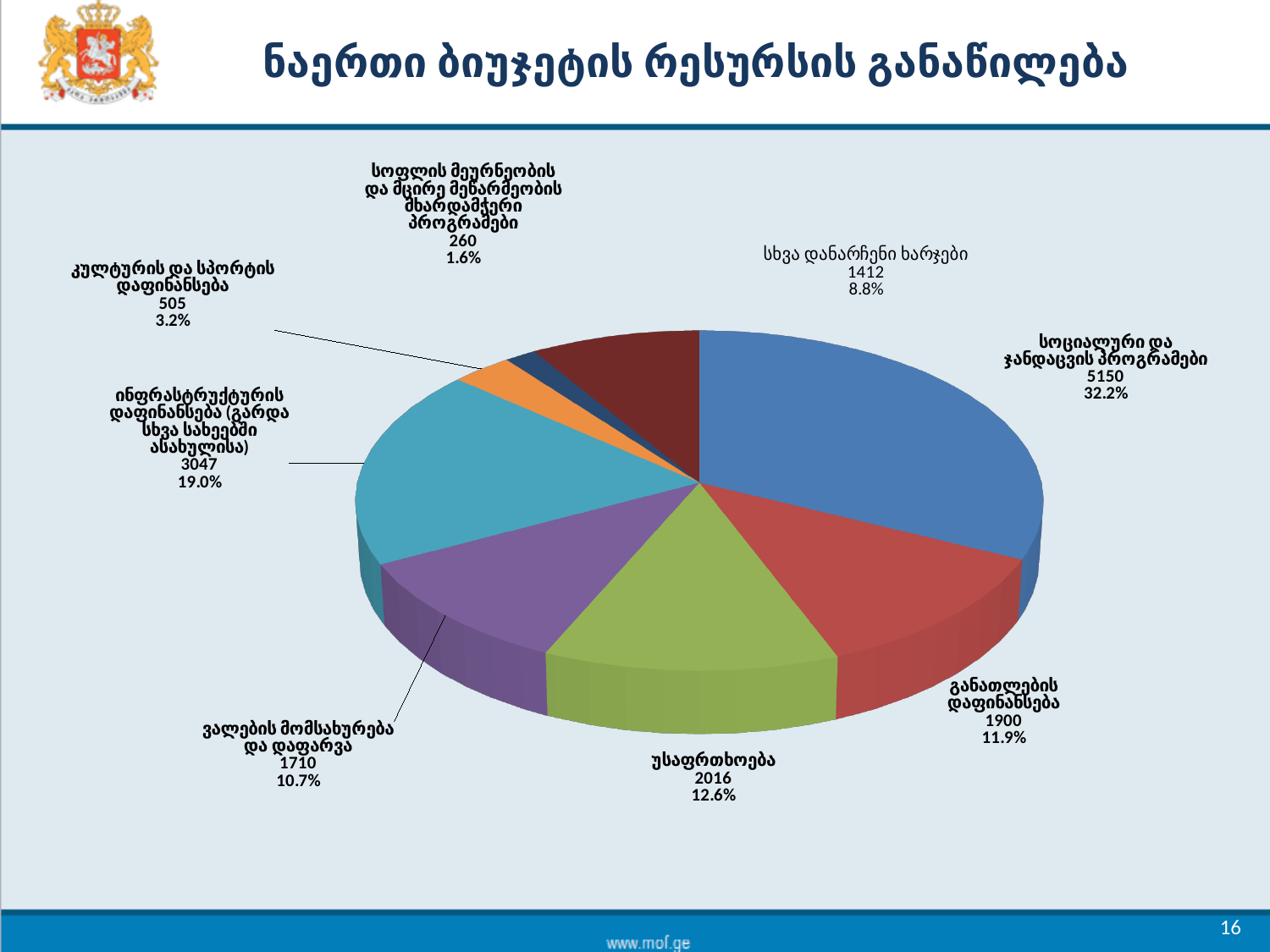
Which category has the largest slice of the pie? სოციალური და ჯანდაცვის პროგრამები What kind of chart is shown on the slide? pie chart Which is larger, the value for ვალების მომსახურება და დაფარვა or the value for სხვა დანარჩენი ხარჯები? ვალების მომსახურება და დაფარვა Which category has the smallest slice of the pie? სოფლის მეურნეობის და მცირე მეწარმეობის მხარდამჭერი პროგრამები What is the value shown for სოციალური და ჯანდაცვის პროგრამები? 5150 How many slices does the pie chart have? 8 What is the title of the slide containing the pie chart? ნაერთი ბიუჯეტის რესურსის განაწილება What is the difference between the values for უსაფრთხოება and განათლების დაფინანსება? 116 What percentage is shown for უსაფრთხოება? 12.6% What share of the pie does სოციალური და ჯანდაცვის პროგრამები represent? 32.2% What is the value shown for ინფრასტრუქტურის დაფინანსება (გარდა სხვა სახეებში ასახულისა)? 3047 What percentage is shown for კულტურის და სპორტის დაფინანსება? 3.2%